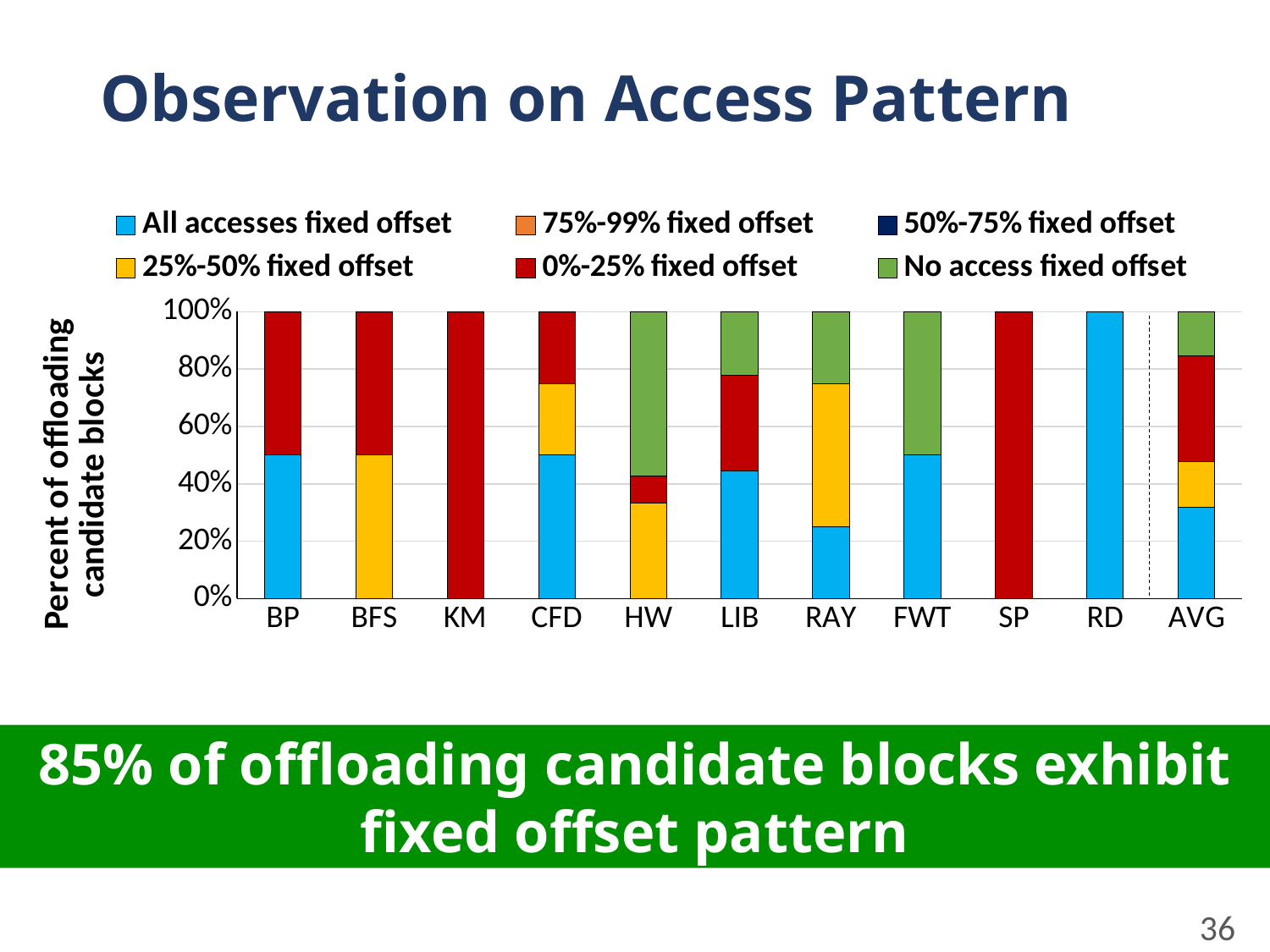
What is the value of the "All accesses fixed offset" segment for RD? 100% What is the value of the "0%-25% fixed offset" segment for KM? 100% Is the "No access fixed offset" segment for HW greater or less than 40%? greater What kind of chart is shown on the slide? Stacked bar chart Which is larger: the "All accesses fixed offset" segment for BP or for RAY? BP What is the title of the y axis of the chart? Percent of offloading candidate blocks Is the "All accesses fixed offset" segment for AVG greater or less than 40%? less Which is larger: the "25%-50% fixed offset" segment for CFD or for RAY? RAY How many series does the chart's legend list? 6 Which category has the largest "All accesses fixed offset" segment? RD What is the value of the "0%-25% fixed offset" segment for SP? 100% How many categories are shown along the x axis of the chart? 11